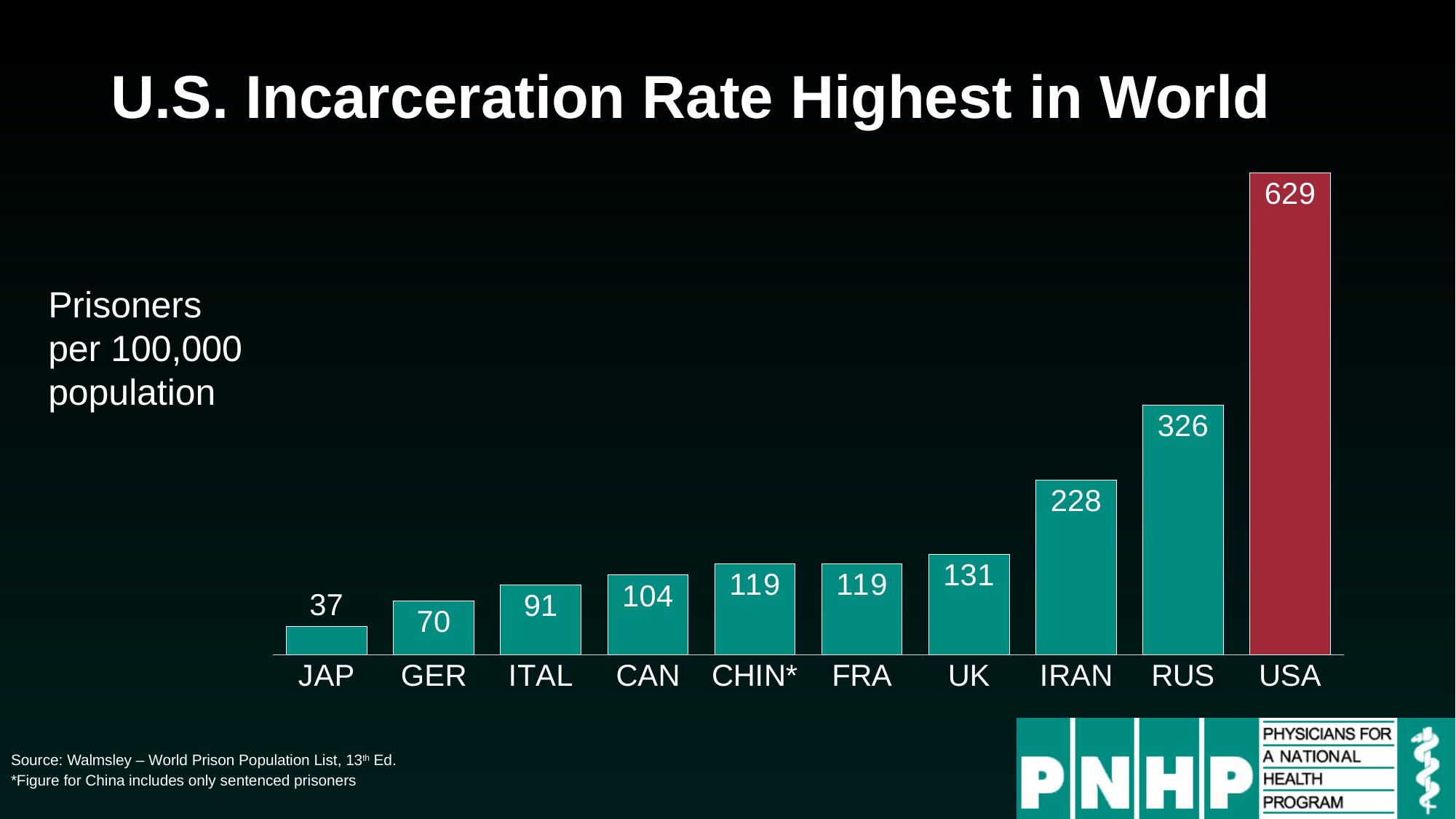
Which bar is coloured differently from the others? USA What is the value for IRAN? 228 How many categories are shown on the x axis? 10 Which category has the lowest value? JAP Which category has the highest value? USA What is the value for RUS? 326 What is the value for USA? 629 What is the difference between the values for UK and GER? 61 What is the value for JAP? 37 What is the difference between the values for USA and RUS? 303 What kind of chart is shown on the slide? Bar chart Which is larger, the value for IRAN or the value for UK? IRAN